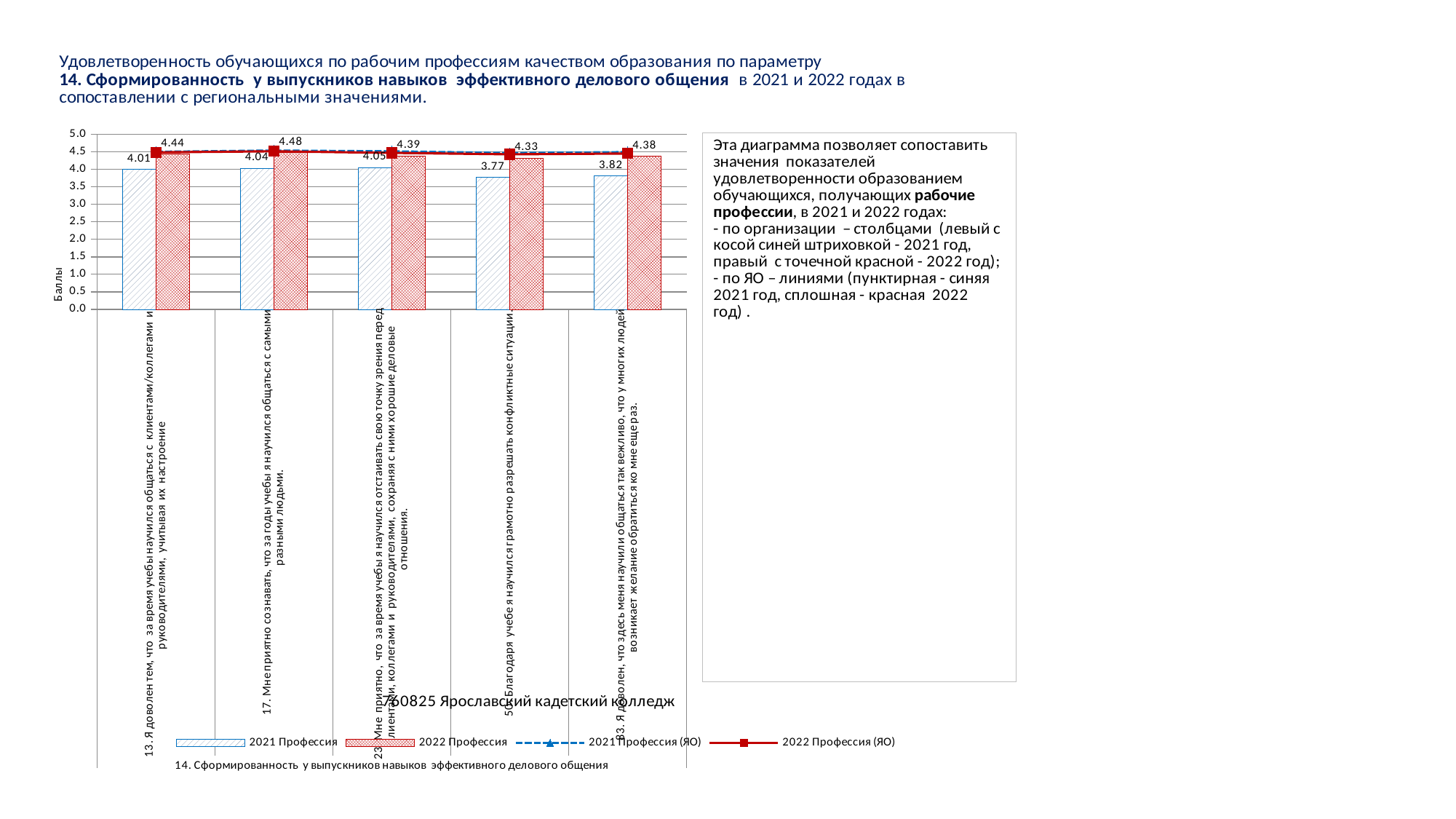
For which statement is the 2021 Профессия bar the highest? 23 (4.05) What is the value of the 2021 Профессия bar for statement 50 (Благодаря учебе я научился грамотно разрешать конфликтные ситуации)? 3.77 What is the label on the vertical axis of the chart? Баллы What is the value of the 2021 Профессия bar for statement 13 (Я доволен тем, что за время учебы научился общаться с клиентами/коллегами и руководителями)? 4.01 What is the difference between the 2021 Профессия values for statement 23 (4.05) and statement 13 (4.01)? 0.04 What kind of chart is shown on the slide? A combined bar and line chart For which statement is the 2021 Профессия bar the lowest? 50. Благодаря учебе я научился грамотно разрешать конфликтные ситуации What is the value of the 2021 Профессия bar for statement 83 (Я доволен, что здесь меня научили общаться так вежливо...)? 3.82 How many series does the chart legend list? 4 Is the 2022 Профессия bar for statement 50 greater or less than 4.0? greater Which is larger: the 2021 Профессия value for statement 17 or for statement 83? Statement 17 (4.04) How many statement categories are plotted along the x axis of the chart? 5